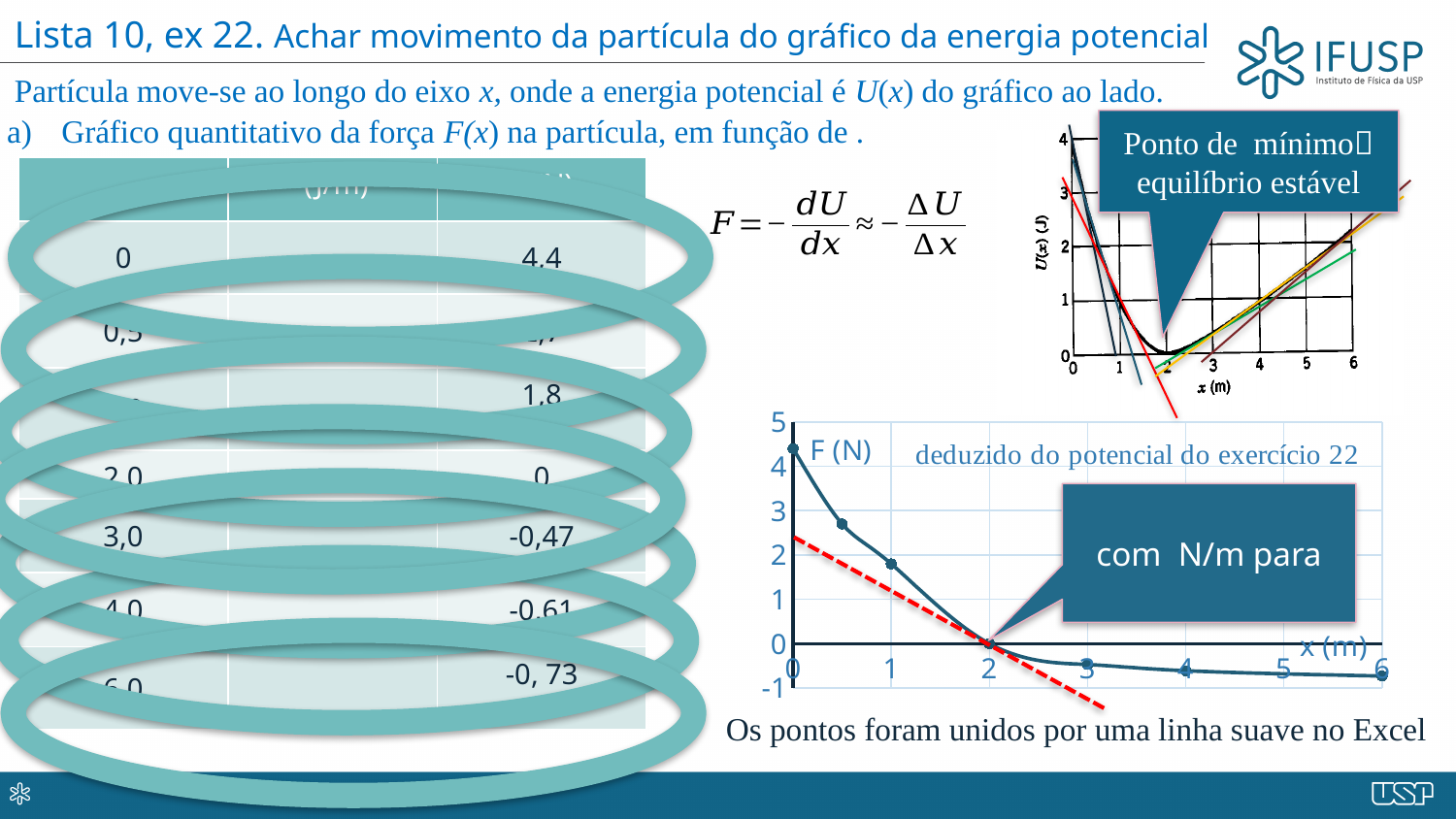
In the F (N) chart, is the value at x = 0.5 greater or less than 2? greater In the F (N) chart, is the value at x = 4 greater or less than -1? greater In the F (N) chart, is the value at x = 3 greater or less than 0? less What is the label of the vertical axis of the small potential-energy chart in the upper right? U(x) (J) In the F (N) chart, which is larger: the value at x = 0 or the value at x = 6? x = 0 What kind of chart is the F (N) versus x (m) chart on the slide? line chart In the F (N) chart, do the values rise or fall as x increases from 0 to 6? fall In the F (N) chart, at which value of x does the curve cross F = 0? 2 In the F (N) chart, at which x value is the force highest? 0 What is the label of the horizontal axis of the F (N) chart? x (m)